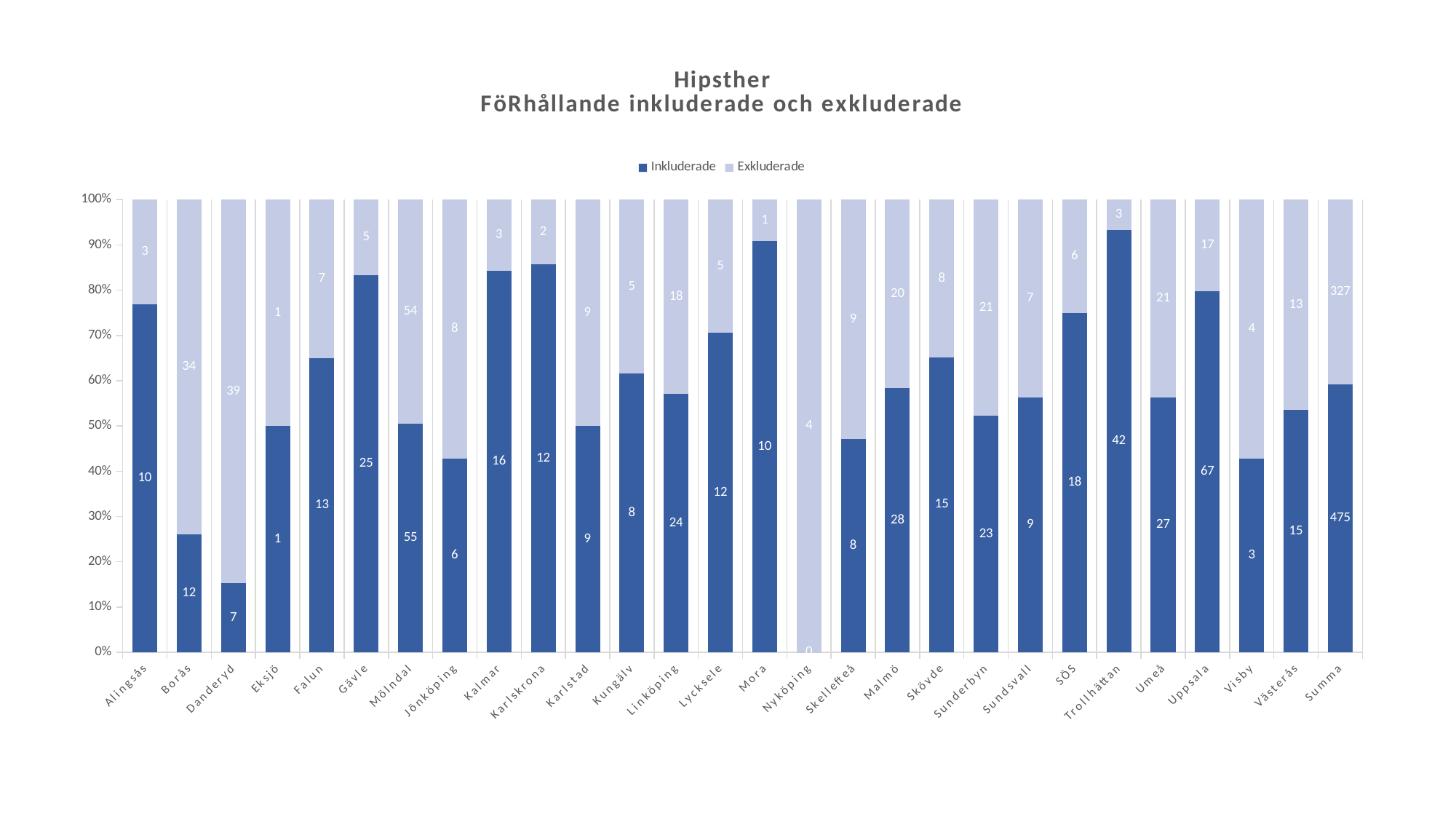
Which category has the highest Exkluderade value? Summa How many categories are shown on the x axis? 28 What kind of chart is shown on the slide? Stacked bar chart What is the Exkluderade value for Danderyd? 39 What is the Inkluderade value for Uppsala? 67 What is the difference between the Inkluderade and Exkluderade values for Borås? 22 Which category has the lowest Inkluderade value? Nyköping Which is larger for Linköping, the Inkluderade value or the Exkluderade value? Inkluderade What is the Inkluderade value for Summa? 475 How many series does the legend list? 2 What is the total of the Inkluderade and Exkluderade values for Mölndal? 109 Is the Inkluderade share of the Trollhättan bar greater or less than 90%? greater